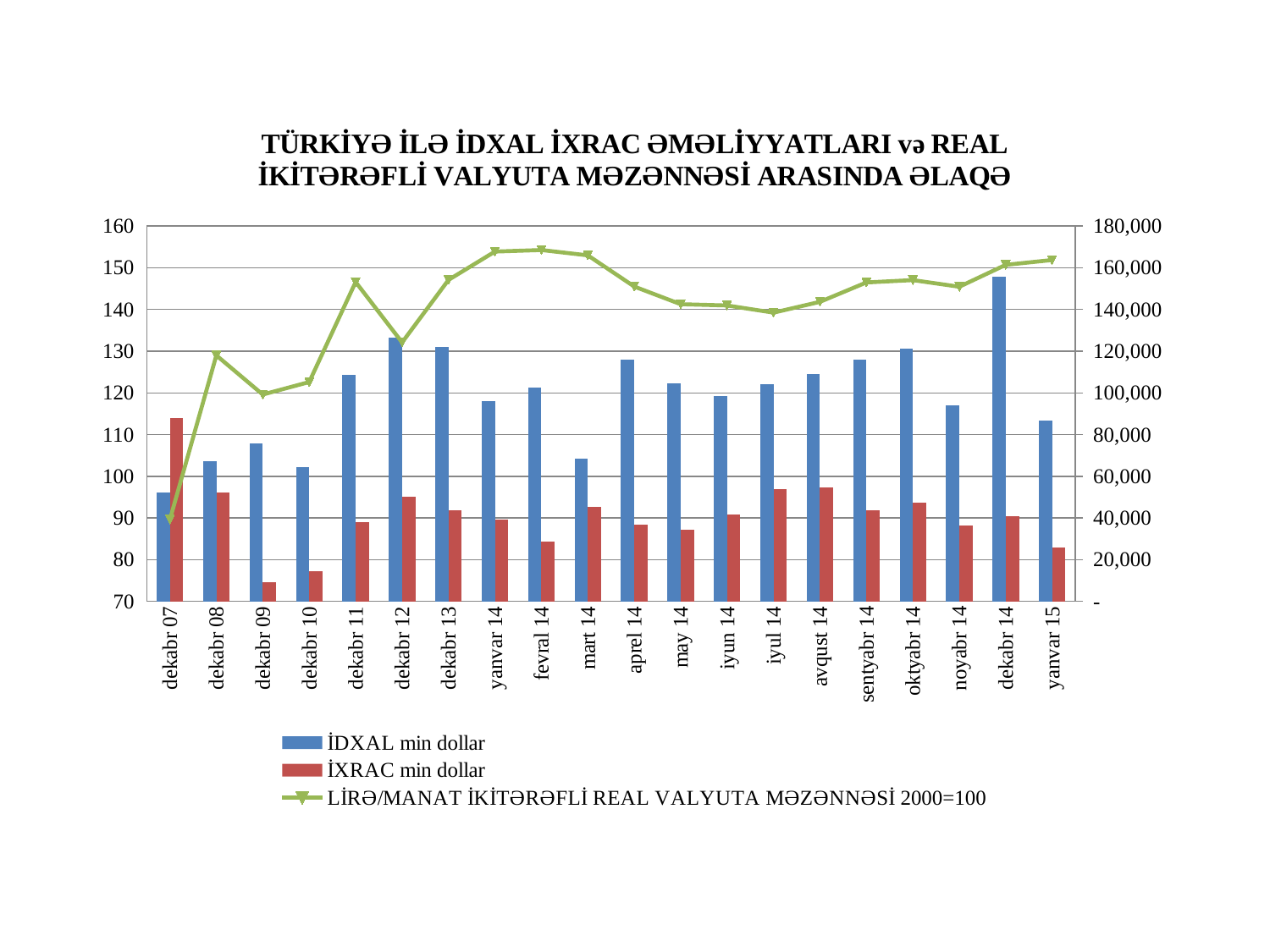
Which is larger: the İDXAL bar for dekabr 14 or the İDXAL bar for yanvar 15? dekabr 14 In dekabr 07, which is larger: the İDXAL bar or the İXRAC bar? İXRAC Which series is drawn as a green line with triangle markers? LİRƏ/MANAT İKİTƏRƏFLİ REAL VALYUTA MƏZƏNNƏSİ 2000=100 In which period is the LİRƏ/MANAT real exchange rate line at its lowest point? dekabr 07 What kind of chart is shown on the slide? A combined bar and line chart In which period is the İXRAC min dollar bar the highest? dekabr 07 In which period is the İDXAL min dollar bar the lowest? dekabr 07 How many series does the legend list? 3 Does the LİRƏ/MANAT real exchange rate line rise or fall from dekabr 07 to dekabr 08? rise In which period is the İDXAL min dollar bar the highest? dekabr 14 On the left axis, is the LİRƏ/MANAT real exchange rate value for dekabr 07 greater or less than 100? less How many time periods are shown along the x axis? 20